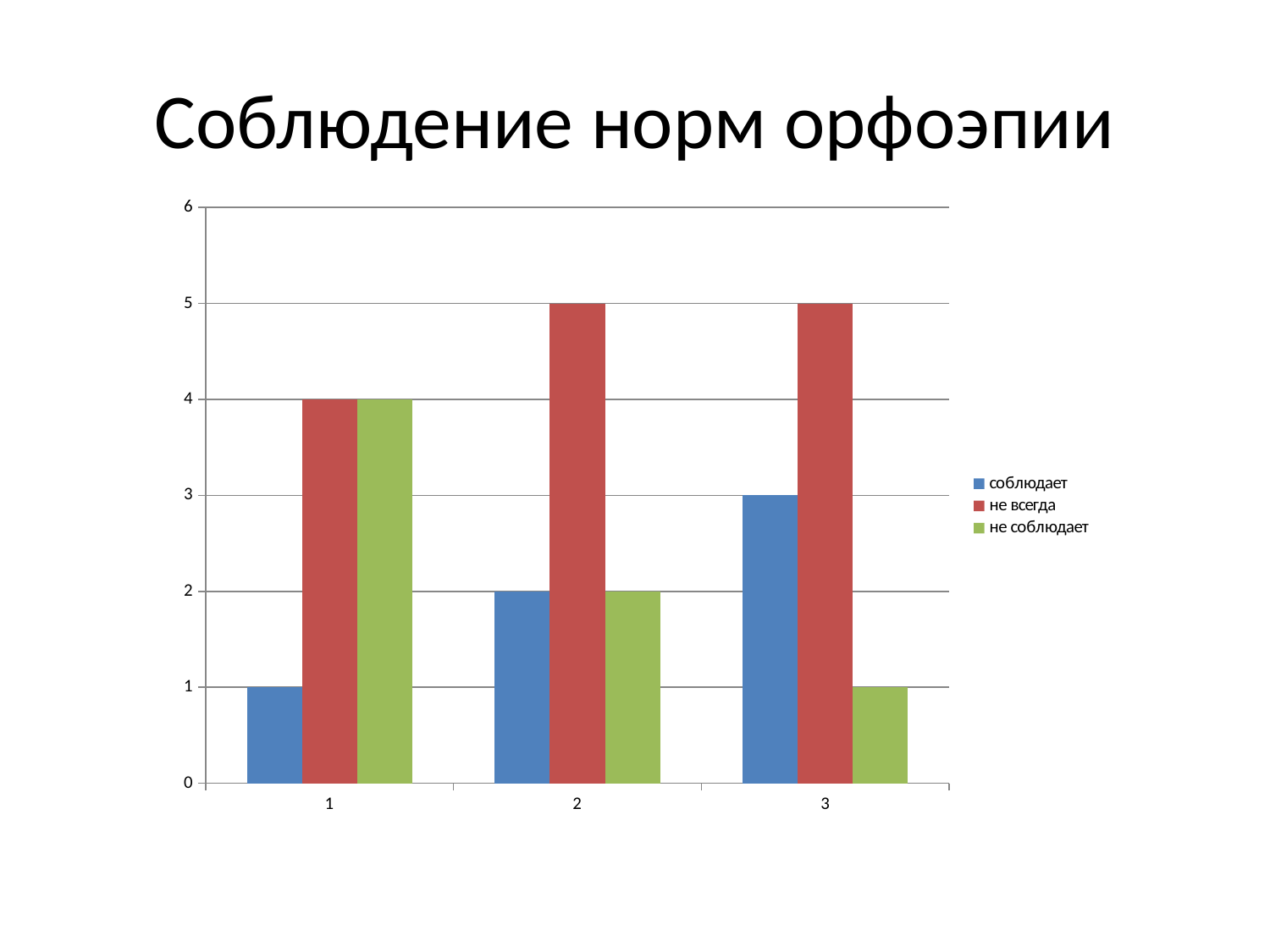
How many series does the legend list? 3 What is the title of the chart? Соблюдение норм орфоэпии What is the value of the 'не соблюдает' series for category 3? 1 For which category is the 'не соблюдает' series lowest? 3 What is the value of the 'соблюдает' series for category 1? 1 What is the difference between the 'не всегда' and 'соблюдает' values for category 1? 3 How many categories are shown on the x axis? 3 For which category is the 'соблюдает' series highest? 3 What is the value of the 'не всегда' series for category 2? 5 What kind of chart is shown on the slide? bar chart Does the 'соблюдает' series rise or fall from category 1 to category 3? rise Which is larger for category 2: the 'не всегда' value or the 'не соблюдает' value? не всегда